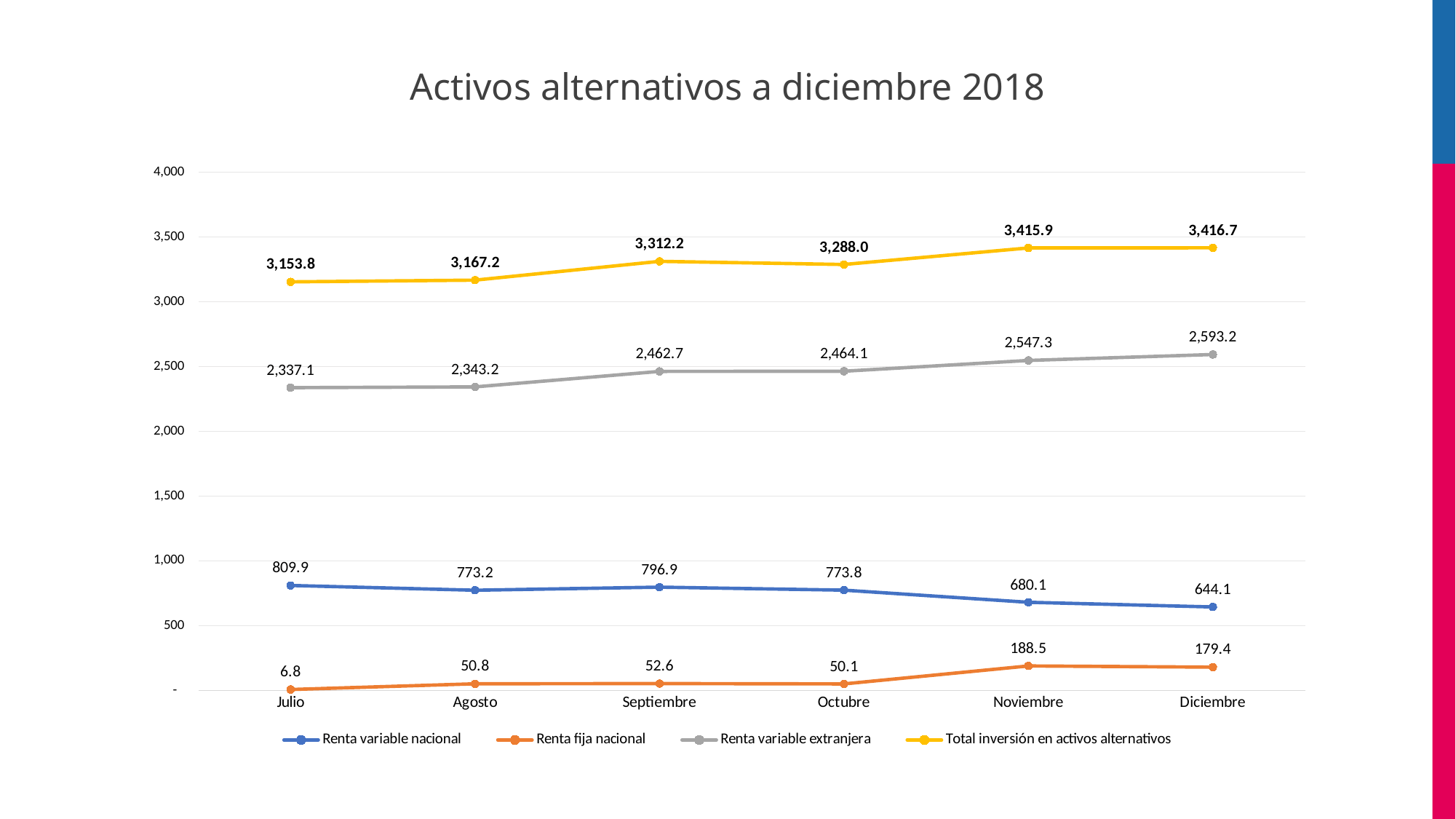
How many months are shown on the x axis? 6 In which month is Renta variable nacional highest? Julio In which month is Renta fija nacional lowest? Julio What kind of chart is shown on the slide? line chart Does Renta variable nacional generally rise or fall from Julio to Diciembre? fall What is the value of Renta fija nacional in Julio? 6.8 What is the difference between Renta variable nacional in Julio and in Diciembre? 165.8 Which is larger, Renta fija nacional in Noviembre or in Diciembre? Noviembre What is the value of Renta variable extranjera in Septiembre? 2,462.7 How many series does the legend list? 4 Is the value for Renta variable extranjera in Diciembre greater or less than 2,500? greater What is the value of Total inversión en activos alternativos in Diciembre? 3,416.7